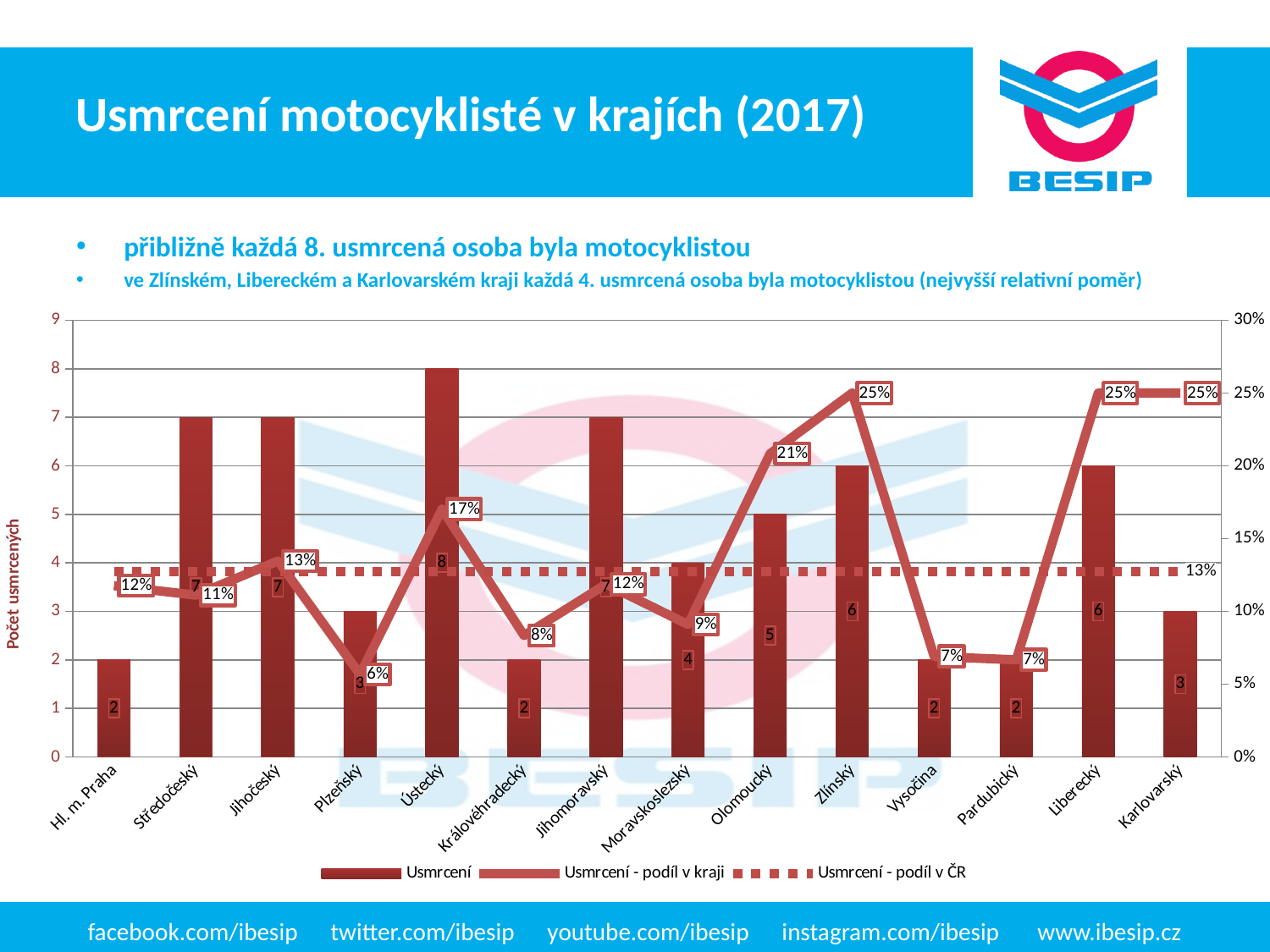
What is the difference between the Usmrcení values for Ústecký and Plzeňský? 5 Is the Usmrcení - podíl v kraji value for Zlínský greater or less than 20%? greater Which is larger, the Usmrcení value for Zlínský or for Karlovarský? Zlínský Which region has the lowest Usmrcení - podíl v kraji value? Plzeňský How many series does the legend list? 3 What is the Usmrcení value for Hl. m. Praha? 2 What is the Usmrcení - podíl v kraji value for Olomoucký? 21% What value does the dashed Usmrcení - podíl v ČR line show? 13% What is the value of the Usmrcení bar for Ústecký? 8 What is the title of the slide containing the chart? Usmrcení motocyklisté v krajích (2017) How many regions are shown on the x axis? 14 Which region has the highest Usmrcení bar? Ústecký